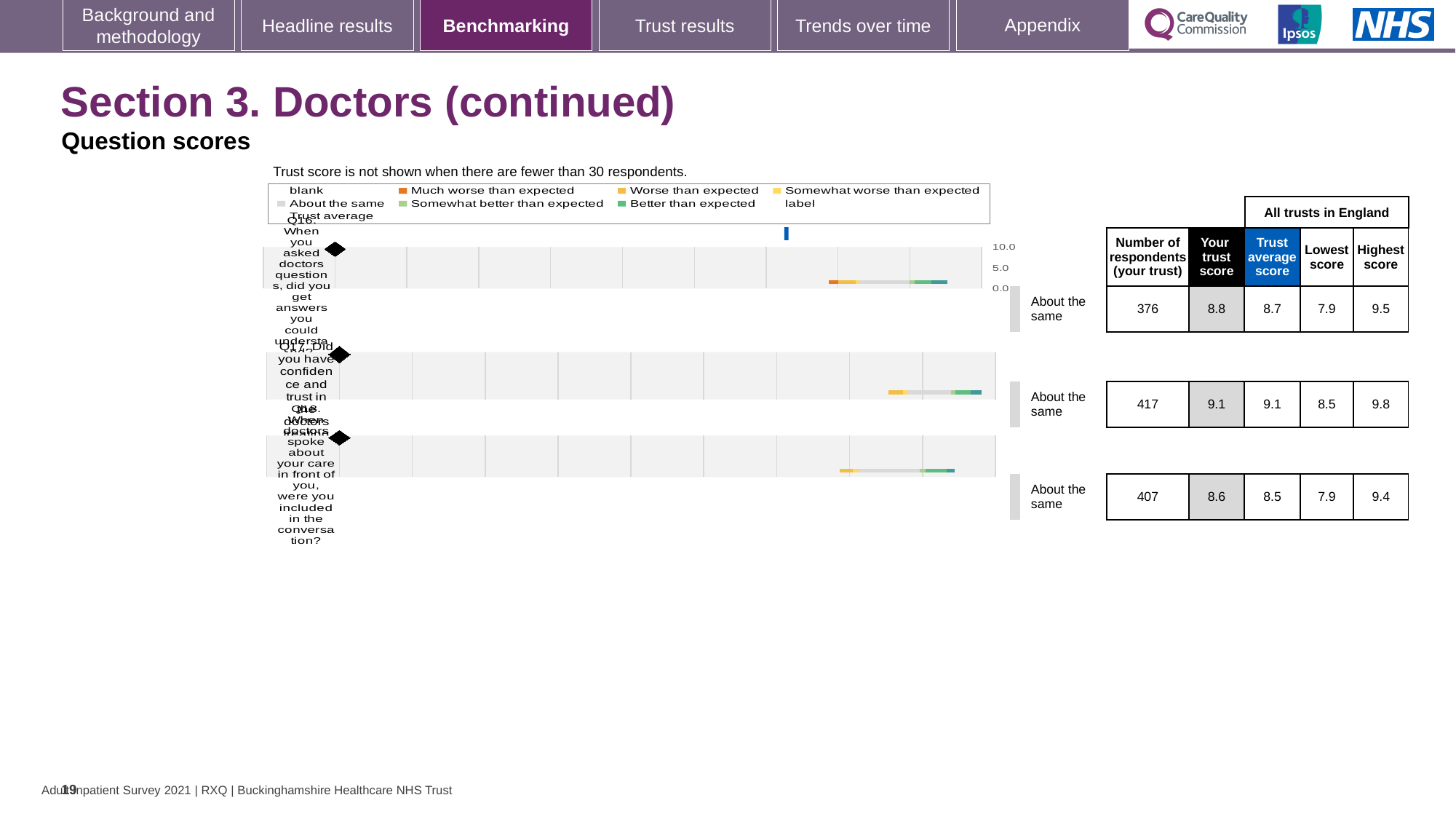
How many questions are plotted in the question scores chart? 3 Which question has the lowest 'Your trust score'? Q18 For Q16, which is larger: 'Your trust score' or the 'Trust average score'? Your trust score (8.8) Which question has the highest 'Your trust score'? Q17 What is the 'Lowest score' across all trusts in England for Q17? 8.5 What is the 'Highest score' across all trusts in England for Q18? 9.4 What is the 'Your trust score' for Q17 (confidence and trust in the doctors)? 9.1 What kind of chart is used to show the question scores on this slide? Bar chart How many respondents from your trust answered Q16? 376 What is the maximum value shown on the chart's score axis? 10.0 What benchmark category is shown for Q16 next to the chart? About the same What is the difference between the 'Your trust score' for Q17 and for Q16? 0.3